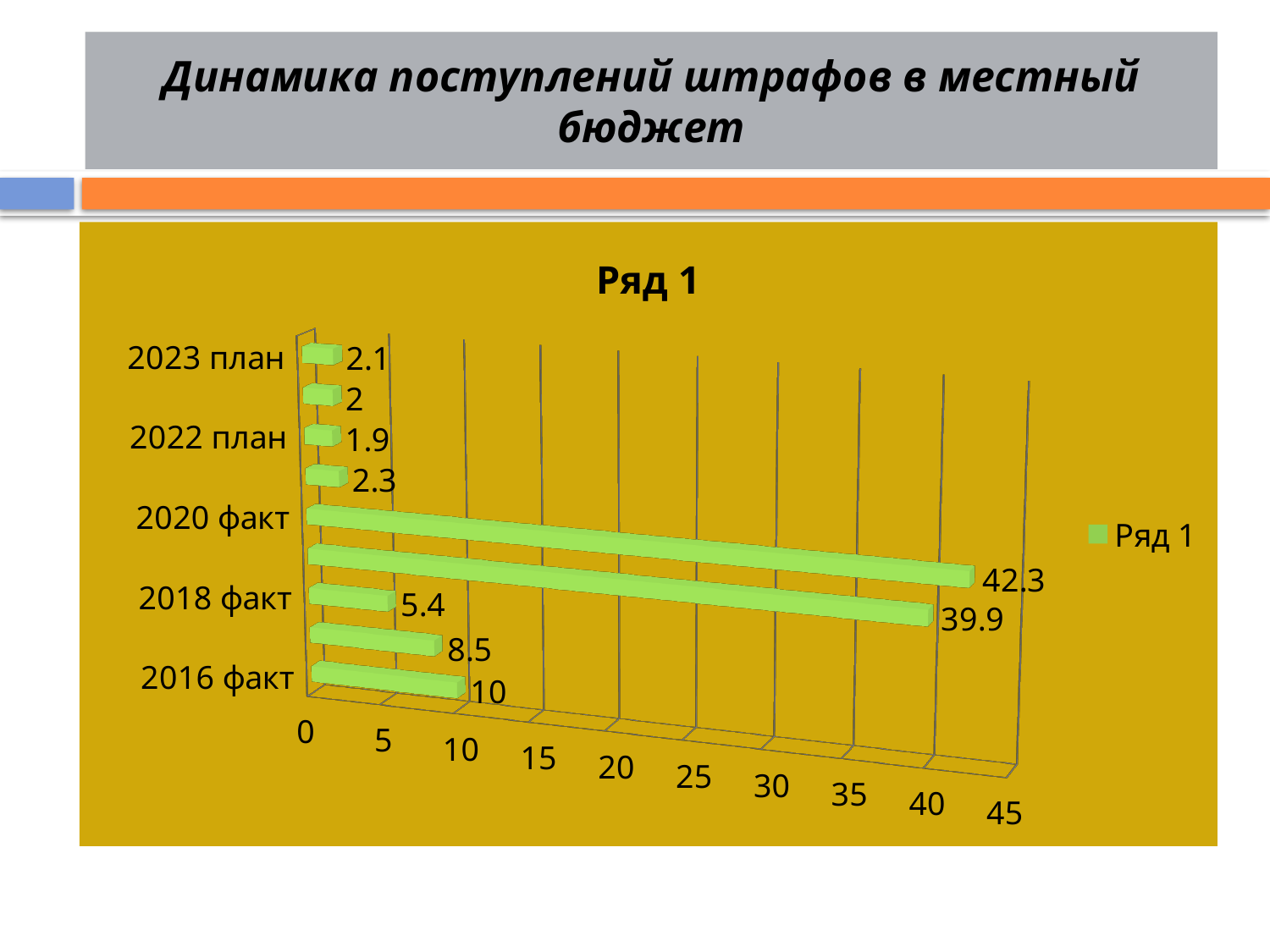
Which category has the highest value? 2020 факт What is the value for 2022 план? 1.9 Is the value for 2020 факт greater or less than 40? greater What is the difference between the values for 2016 факт and 2018 факт? 4.6 Which category has the lowest value? 2022 план What is the value for 2020 факт? 42.3 What is the value for 2018 факт? 5.4 How many series does the legend list? 1 What is the value for 2016 факт? 10 What kind of chart is shown? bar chart Which is larger, the value for 2023 план or 2022 план? 2023 план What is the value for 2023 план? 2.1